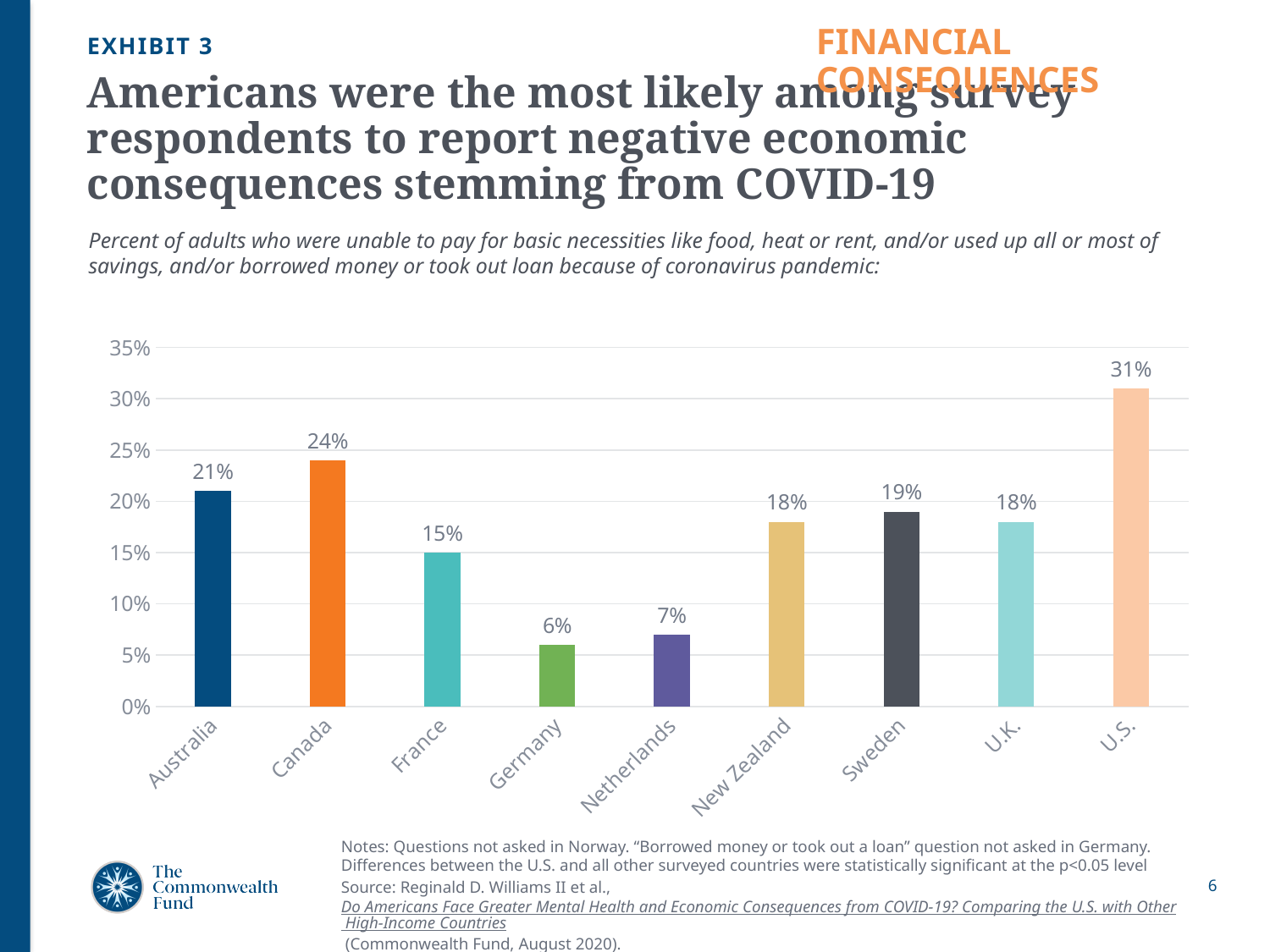
What is the value for Germany? 6% Which country has the lowest value? Germany How many countries are shown on the chart? 9 What is the highest value shown on the vertical axis? 35% What is the value for Sweden? 19% Which is larger, the value for Australia or the value for Sweden? Australia What is the difference between the values for Canada and France? 9% What is the value for Canada? 24% Which country has the highest value? U.S. What kind of chart is shown on the slide? bar chart What is the difference between the values for the U.S. and Australia? 10% Is the value for the U.S. greater or less than 30%? greater